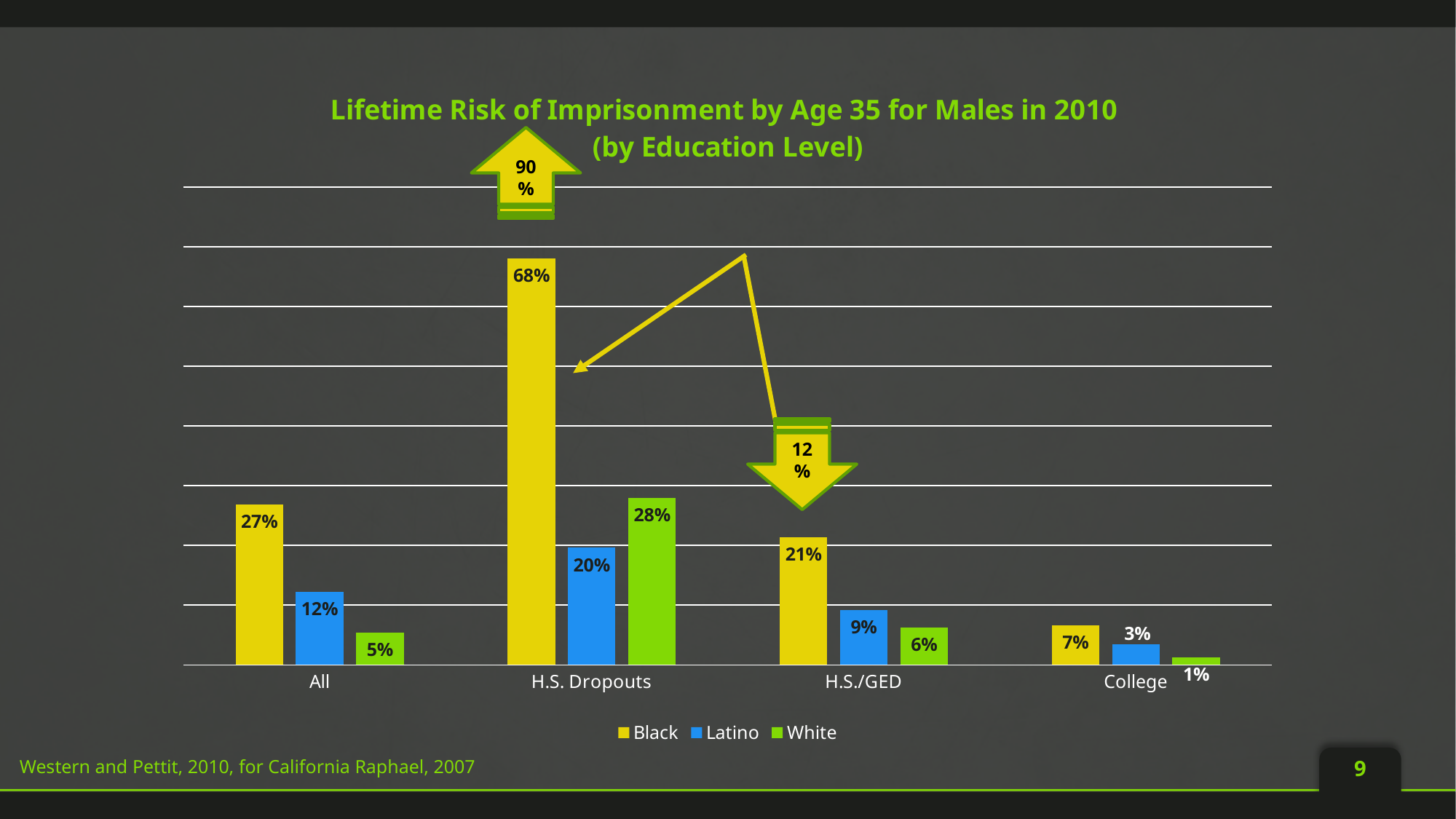
Which education level has the lowest value for Latino males? College What is the value for White males in the College category? 1% How many series does the legend list? 3 Which is larger in the H.S./GED category, the Latino value or the White value? Latino Which series is shown in blue in the legend? Latino What kind of chart is shown on the slide? Bar chart What is the difference between the Black and White values in the H.S. Dropouts category? 40% What is the value for White males in the H.S. Dropouts category? 28% What is the value for Latino males in the All category? 12% Which education level has the highest value for Black males? H.S. Dropouts What is the lifetime risk of imprisonment for Black males who are H.S. Dropouts? 68% How many education-level categories are shown on the x axis? 4